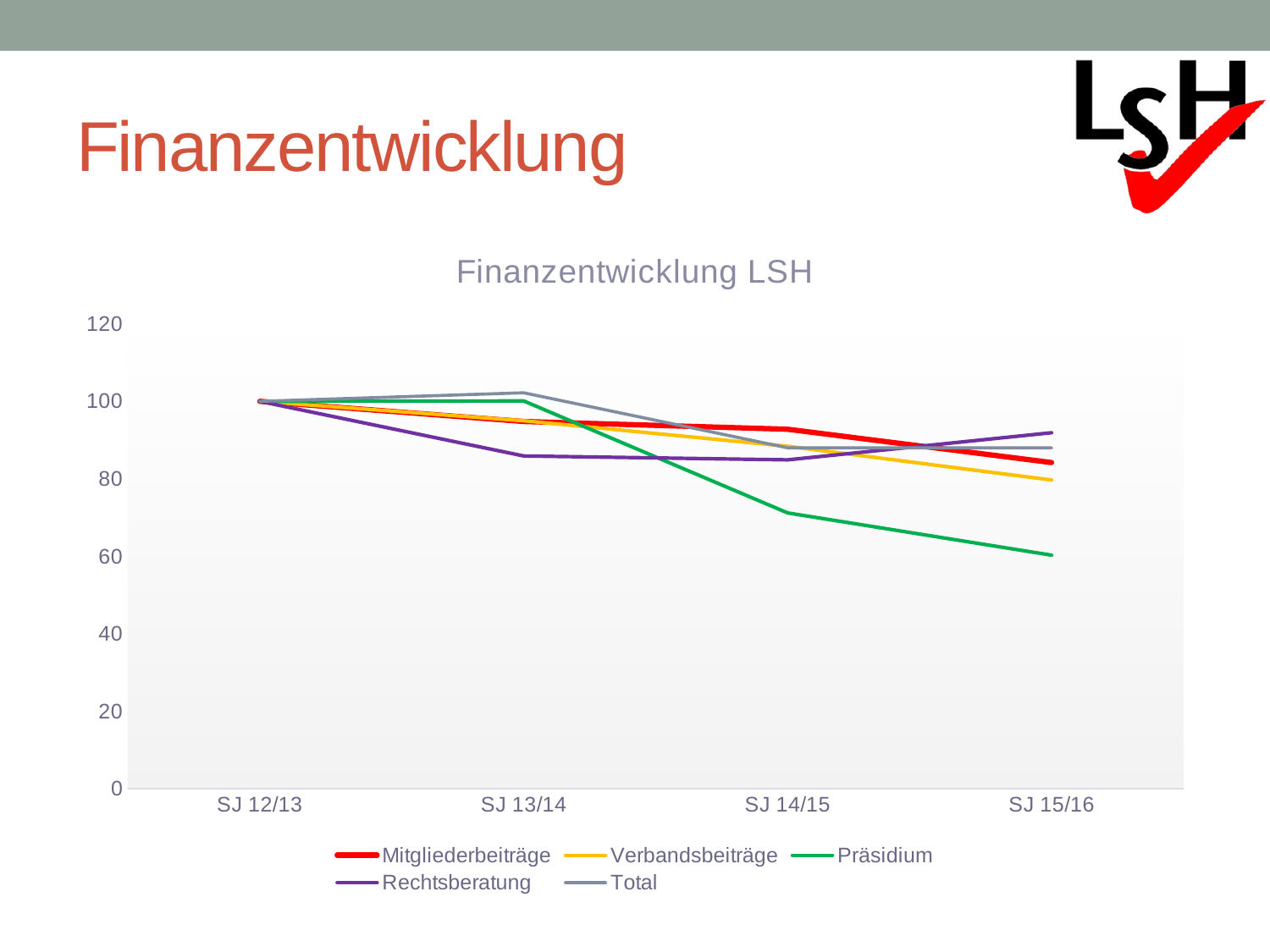
Is the value for Total at SJ 15/16 greater or less than 100? less Is the value for Rechtsberatung at SJ 13/14 greater or less than 80? greater Does the Präsidium line rise or fall from SJ 13/14 to SJ 15/16? fall What kind of chart is shown on the slide? line chart Is the value for Präsidium at SJ 14/15 greater or less than 80? less Which colour is used for the Präsidium line? green How many points are plotted along the x axis? 4 What is the title of the chart? Finanzentwicklung LSH Which series has the lowest value at SJ 15/16? Präsidium How many series does the legend list? 5 At SJ 15/16, which is larger: Mitgliederbeiträge or Präsidium? Mitgliederbeiträge